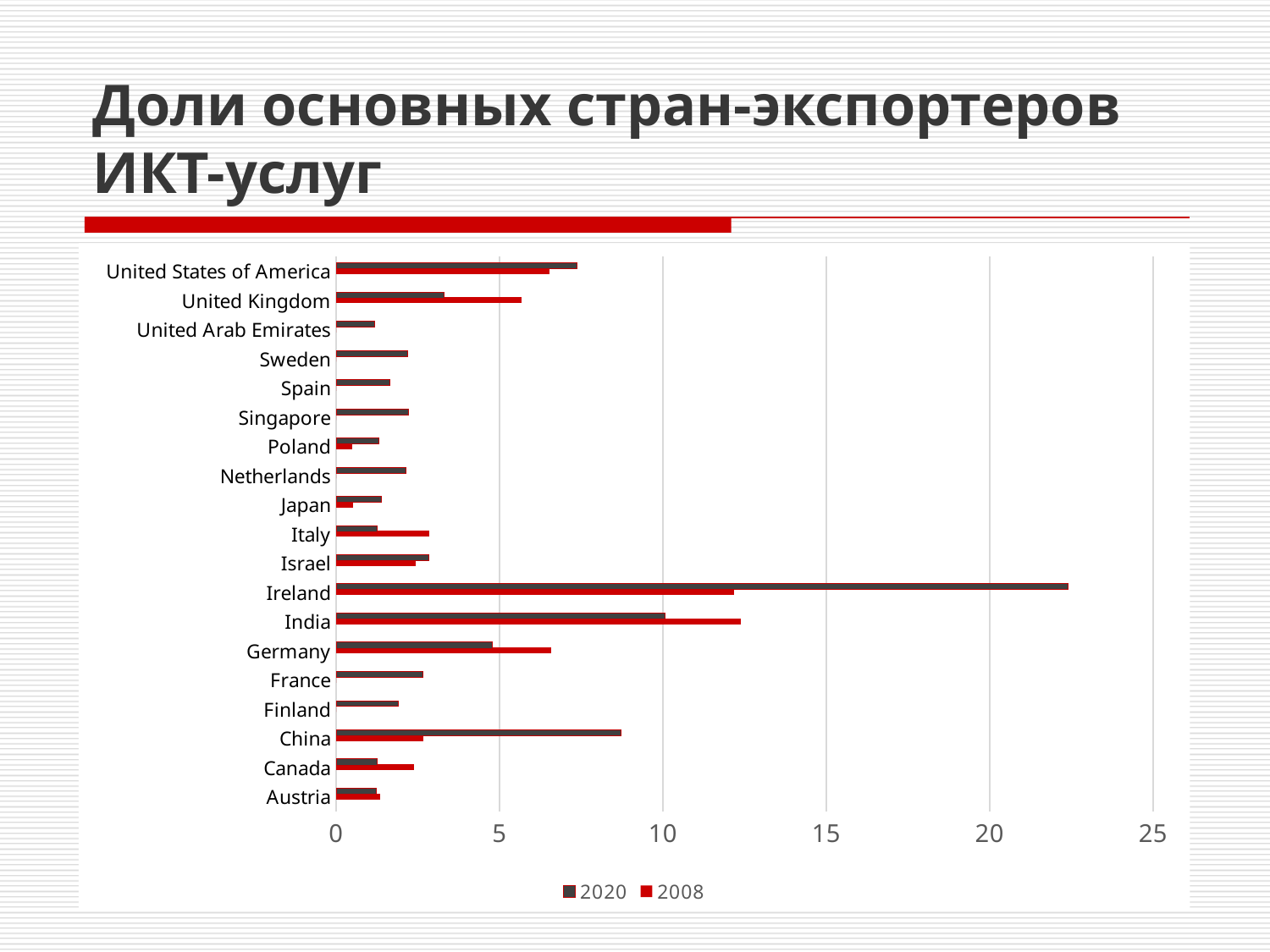
Which country has the highest value for 2008? India Which colour represents the 2008 series in the legend? red Is the 2020 value for United Kingdom greater or less than 5? less How many series does the legend list? 2 Is the 2020 value for United States of America greater or less than 5? greater Which country has the highest value for 2020? Ireland For Ireland, which series has the larger value, 2020 or 2008? 2020 What kind of chart is shown on the slide? bar chart For China, which series has the larger value, 2020 or 2008? 2020 How many countries are shown on the chart? 19 Is the 2020 value for Ireland greater or less than 20? greater